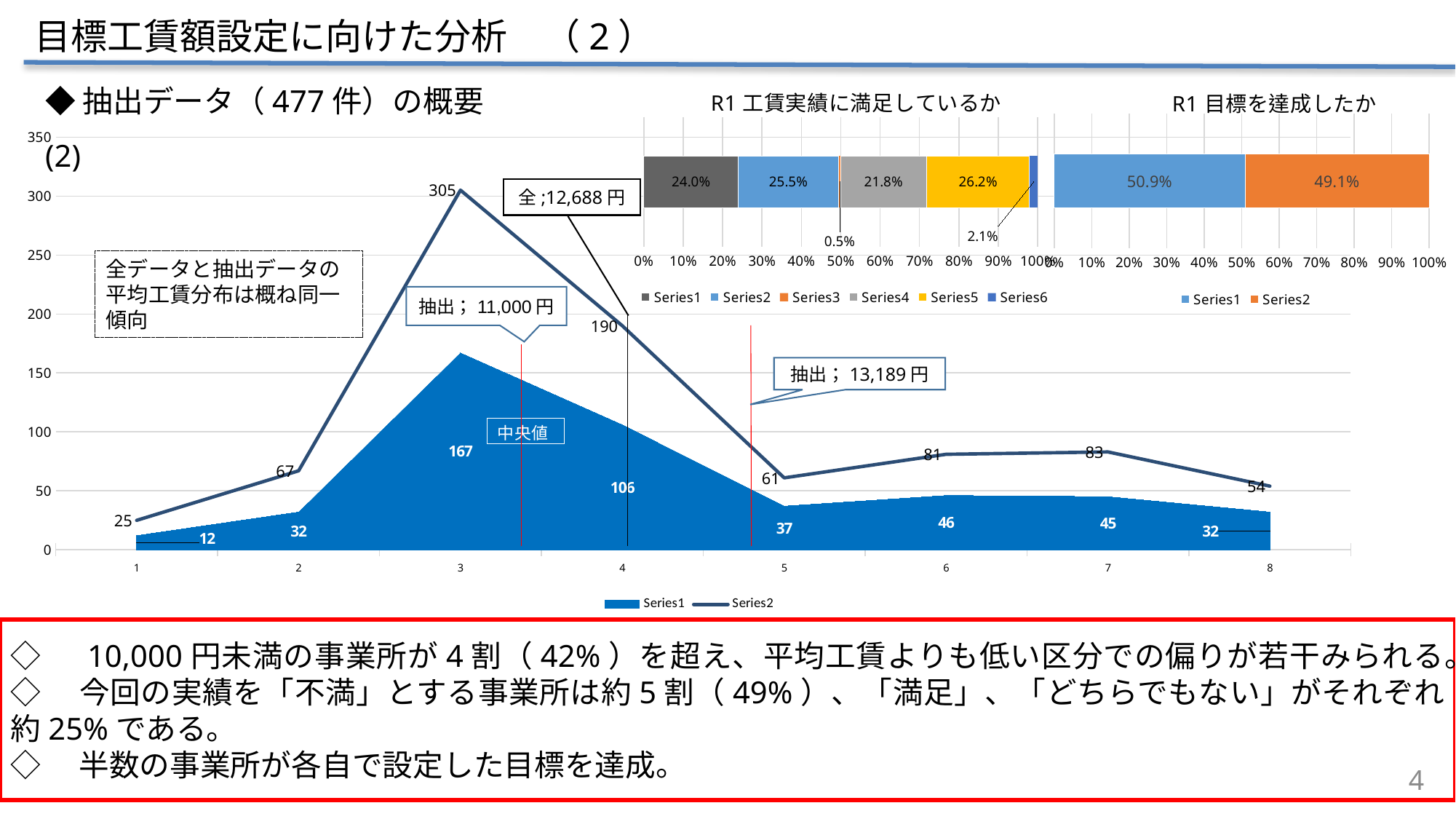
In the large chart on the left, which is larger: Series2 at category 6 or Series2 at category 7? Series2 at category 7 In the large chart on the left, how many series does the legend list? 2 In the large chart on the left, how many categories are shown on the x axis? 8 In the large chart on the left, what is the difference between Series2 and Series1 at category 3? 138 In the chart titled R1 目標を達成したか, what is the value of Series2? 49.1% In the chart titled R1 目標を達成したか, what is the difference between Series1 and Series2? 1.8% In the large chart on the left, what is the value of Series1 at category 4? 106 In the large chart on the left, at which category does Series1 reach its highest value? 3 In the large chart on the left, at which category is Series2 lowest? 1 In the chart titled R1 工賃実績に満足しているか, which series has the smallest value? Series3 In the large chart on the left, what is the value of Series2 at category 3? 305 In the chart titled R1 工賃実績に満足しているか, what is the value of Series5? 26.2%